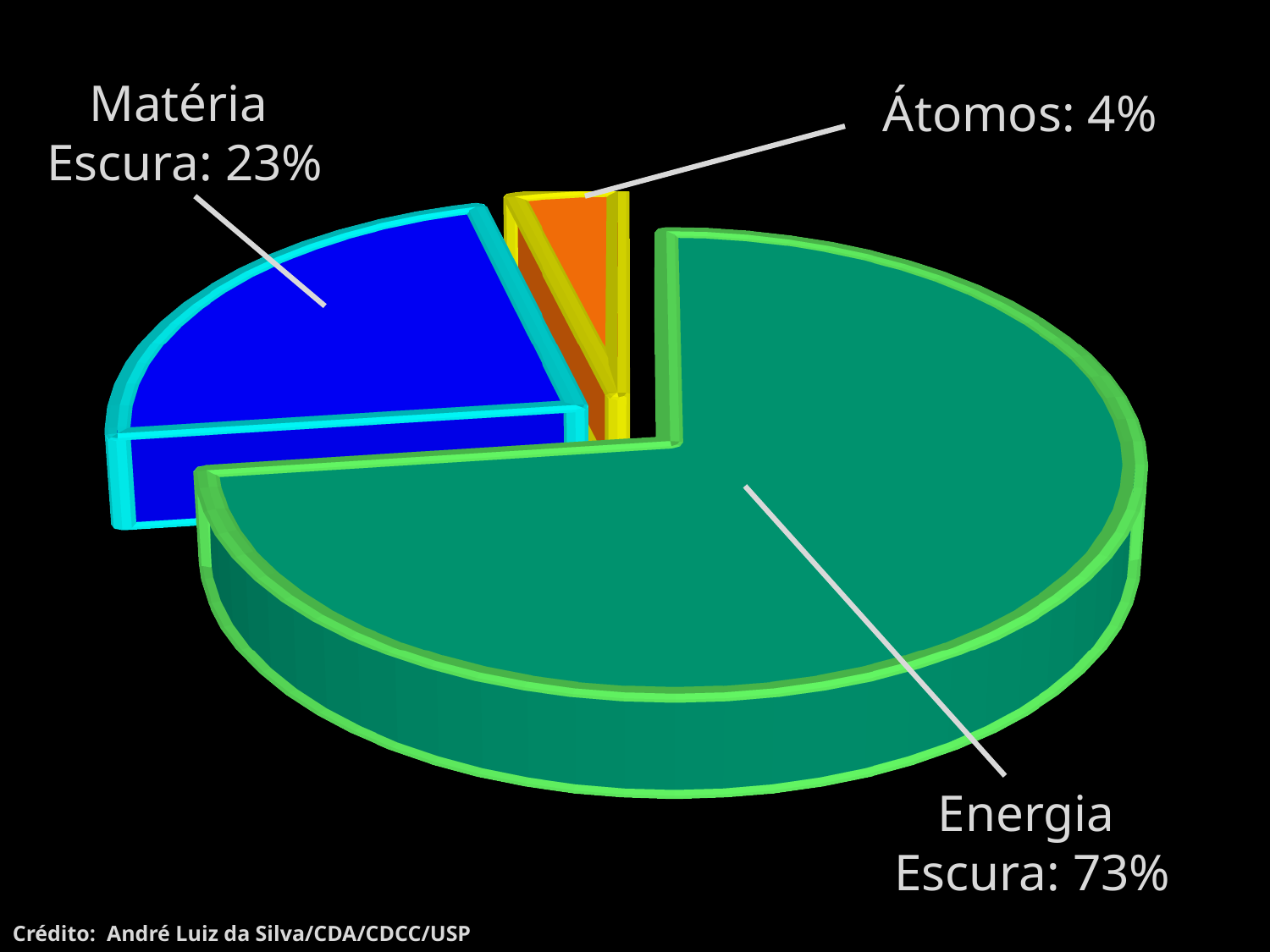
What share of the pie does Energia Escura represent? 73% What is the difference in percentage points between Matéria Escura and Átomos? 19 What colour is the Matéria Escura slice? Blue What kind of chart is shown on the slide? Pie chart What is the difference in percentage points between Energia Escura and Matéria Escura? 50 Which slice of the pie is the largest? Energia Escura What colour is the Energia Escura slice? Green What share of the pie does Átomos represent? 4% Which slice of the pie is the smallest? Átomos What share of the pie does Matéria Escura represent? 23% How many slices does the pie chart have? 3 Which is larger, the share for Matéria Escura or the share for Átomos? Matéria Escura